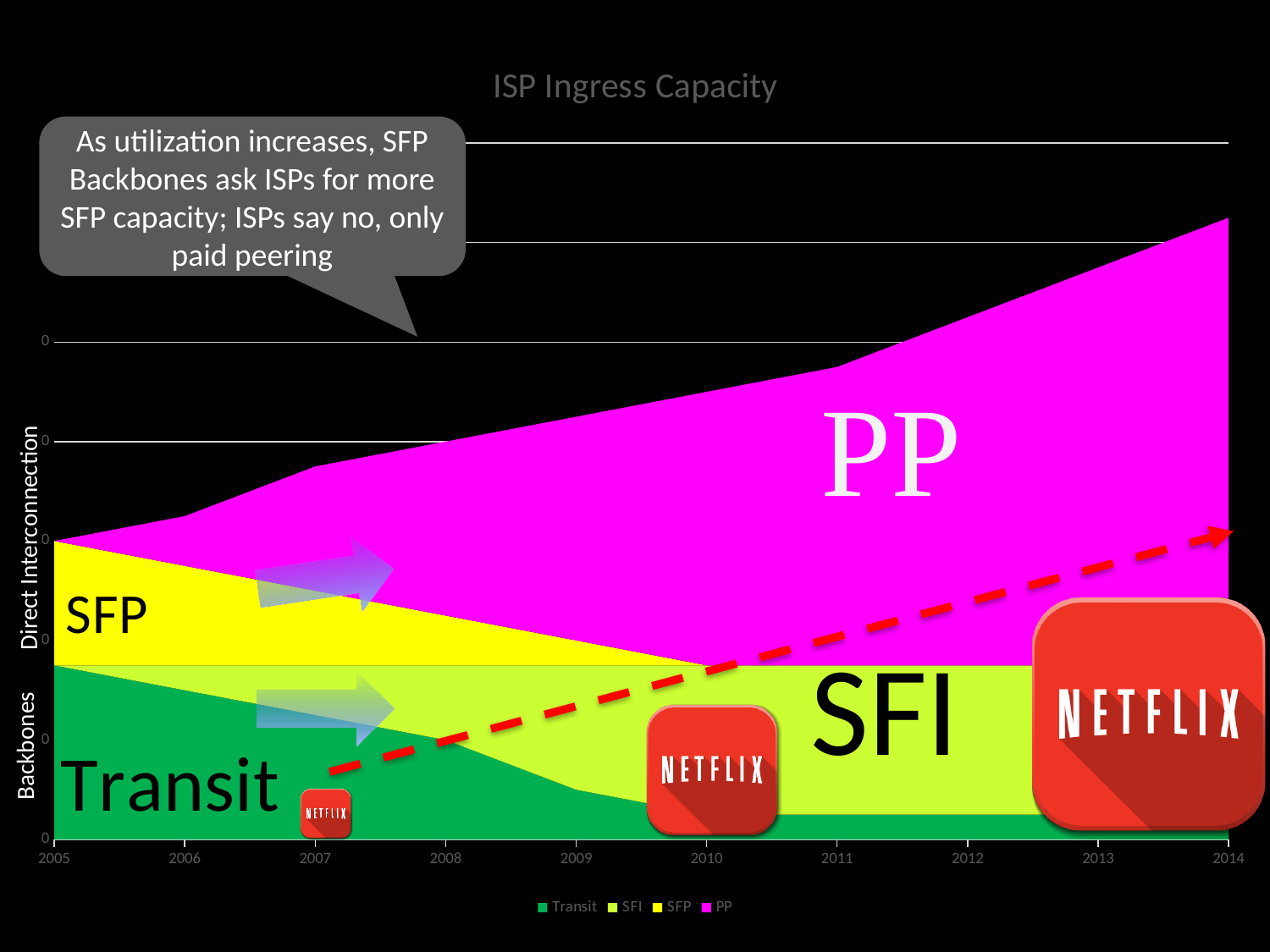
Does the total stacked capacity rise or fall from 2005 to 2014? Rise What are the series names listed in the legend? Transit, SFI, SFP, PP How many series does the legend list? 4 What is the title of the chart? ISP Ingress Capacity Does the Transit series rise or fall from 2005 to 2014? Fall What is the first year shown on the x axis? 2005 Does the PP series rise or fall from 2005 to 2014? Rise What kind of chart is shown on the slide? Area chart In which year does the SFP area shrink to zero? 2010 Which series occupies the largest area in 2014? PP How many years are shown along the x axis? 10 In 2014, which is larger, PP or Transit? PP